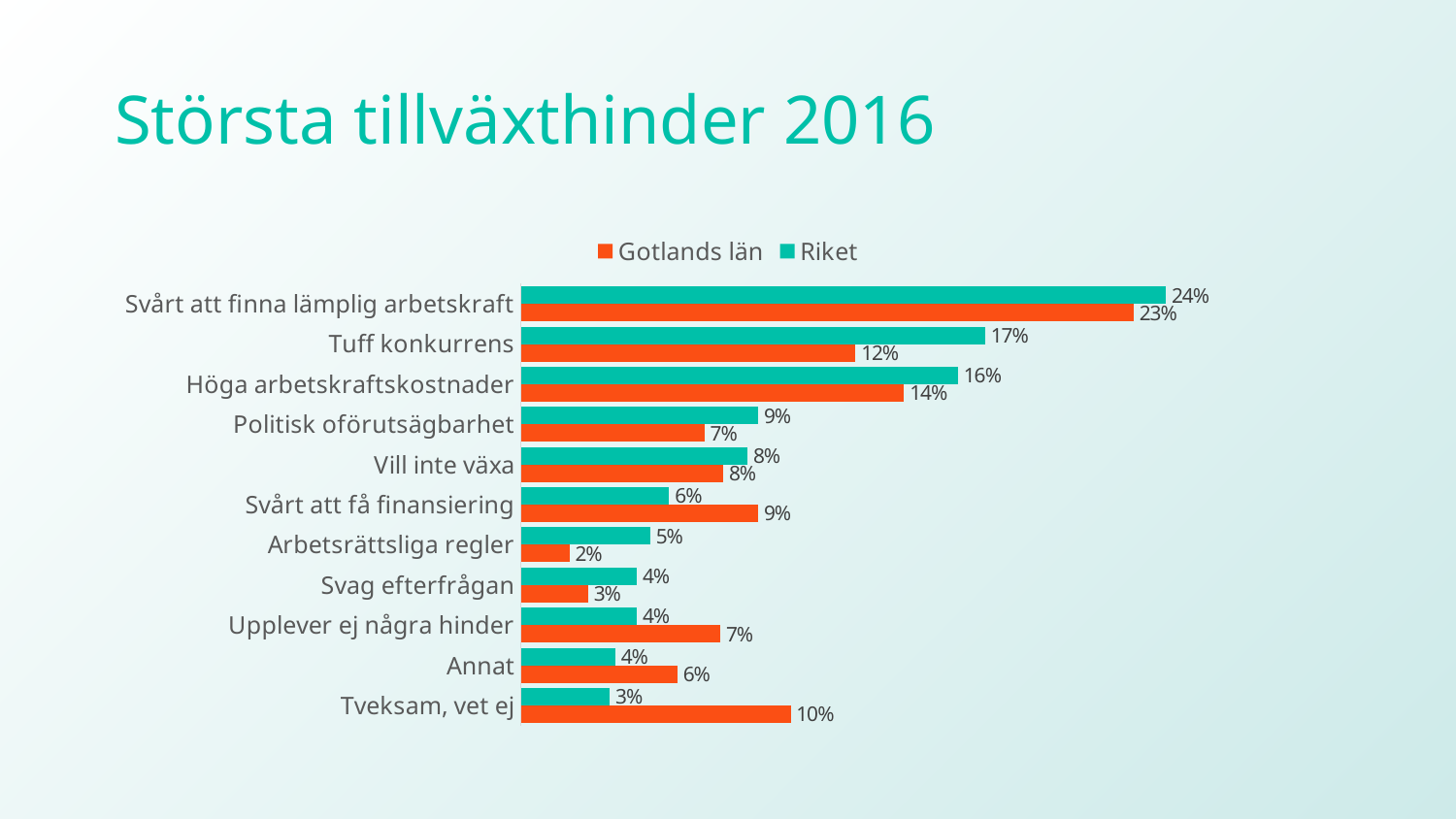
What is the value for Gotlands län for "Tuff konkurrens"? 12% Which series is shown in orange? Gotlands län How many series does the legend list? 2 What is the title of the slide? Största tillväxthinder 2016 What is the difference between Riket and Gotlands län for "Tuff konkurrens"? 5% What kind of chart is shown on the slide? Bar chart What is the value for Gotlands län for "Tveksam, vet ej"? 10% What is the value for Riket for "Svårt att finna lämplig arbetskraft"? 24% Which is larger for "Svårt att få finansiering": Gotlands län or Riket? Gotlands län Which category has the highest value for Gotlands län? Svårt att finna lämplig arbetskraft How many categories are shown in the chart? 11 Which category has the lowest value for Gotlands län? Arbetsrättsliga regler